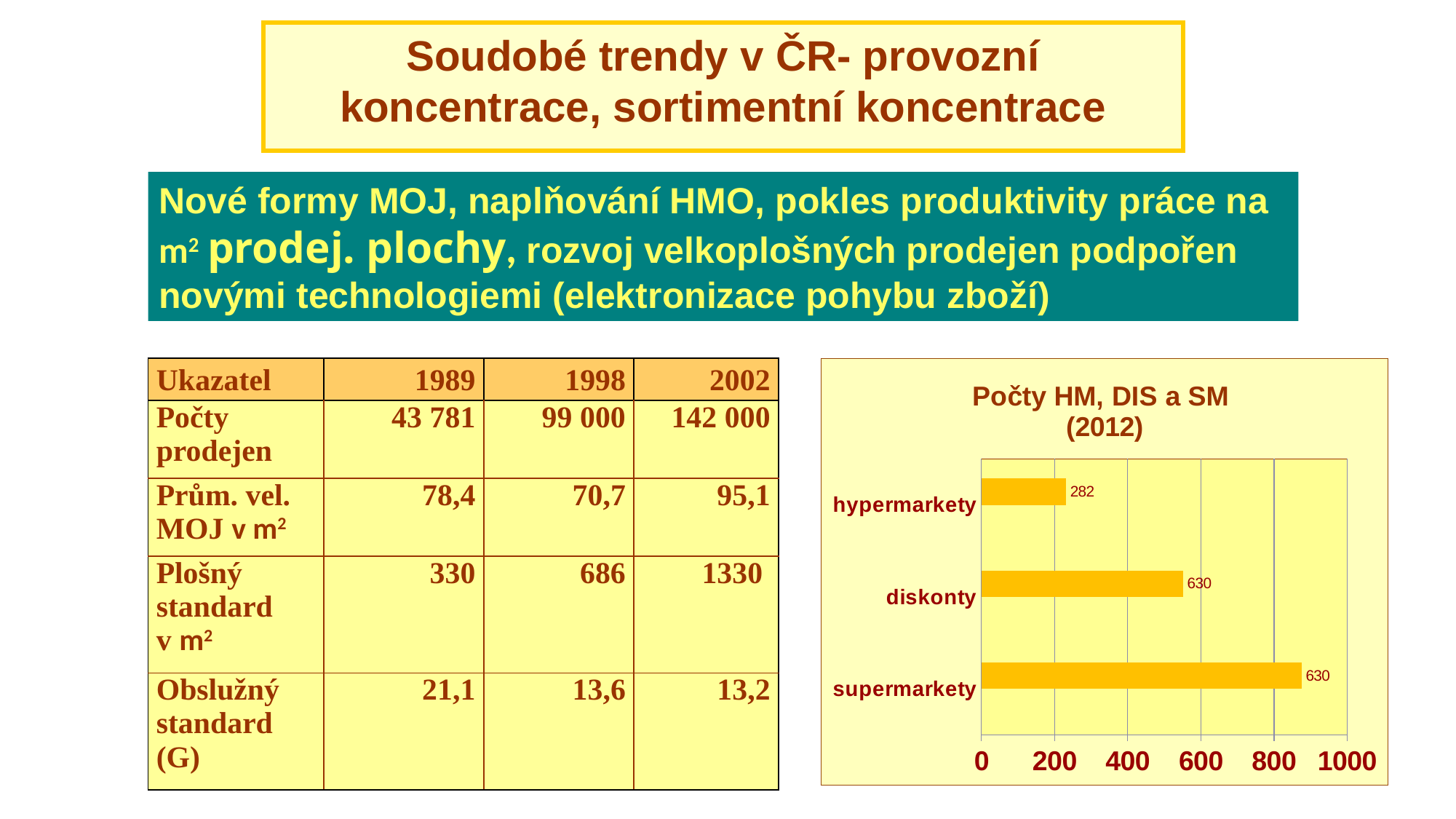
What is the title of the chart on the right side of the slide? Počty HM, DIS a SM (2012) In the chart 'Počty HM, DIS a SM (2012)', what is the difference between the labelled values for diskonty and hypermarkety? 348 What is the highest tick value shown on the horizontal axis of the chart 'Počty HM, DIS a SM (2012)'? 1000 What value is shown for hypermarkety in the chart 'Počty HM, DIS a SM (2012)'? 282 What value is labelled on the diskonty bar in the chart 'Počty HM, DIS a SM (2012)'? 630 What kind of chart is 'Počty HM, DIS a SM (2012)'? bar chart In the chart 'Počty HM, DIS a SM (2012)', is the value for diskonty greater or less than 400? greater In the chart 'Počty HM, DIS a SM (2012)', is the value for hypermarkety greater or less than 400? less Which category has the lowest value in the chart 'Počty HM, DIS a SM (2012)'? hypermarkety In the chart 'Počty HM, DIS a SM (2012)', is the value for supermarkety greater or less than 600? greater In the chart 'Počty HM, DIS a SM (2012)', which is larger, the value for hypermarkety or the value for diskonty? diskonty How many categories are shown in the chart 'Počty HM, DIS a SM (2012)'? 3